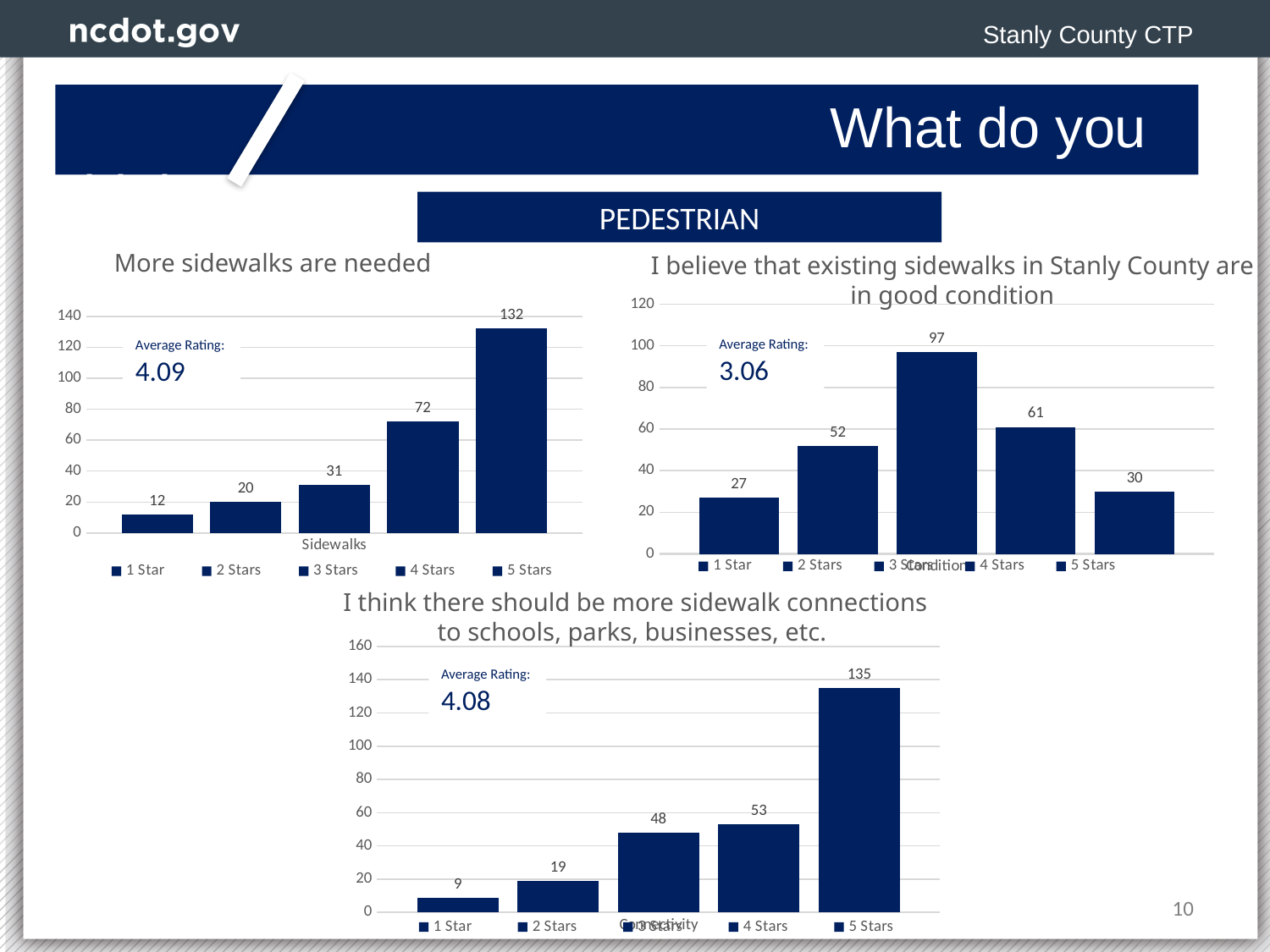
In the 'I believe that existing sidewalks in Stanly County are in good condition' chart, which is larger, the value for 1 Star or the value for 5 Stars? 5 Stars In the 'I believe that existing sidewalks in Stanly County are in good condition' chart, what is the value for 2 Stars? 52 In the 'I think there should be more sidewalk connections to schools, parks, businesses, etc.' chart, what is the value for 1 Star? 9 In the 'I think there should be more sidewalk connections to schools, parks, businesses, etc.' chart, what is the difference between the 5 Stars and 4 Stars values? 82 In the 'More sidewalks are needed' chart, what is the value for 5 Stars? 132 What average rating is shown on the 'I think there should be more sidewalk connections to schools, parks, businesses, etc.' chart? 4.08 In the 'More sidewalks are needed' chart, what is the difference between the 4 Stars and 3 Stars values? 41 In the 'I think there should be more sidewalk connections to schools, parks, businesses, etc.' chart, is the value for 5 Stars greater or less than 120? greater In the 'I believe that existing sidewalks in Stanly County are in good condition' chart, which rating has the highest value? 3 Stars What kind of chart is the 'I believe that existing sidewalks in Stanly County are in good condition' chart? Bar chart In the 'More sidewalks are needed' chart, which rating has the lowest value? 1 Star How many series does the legend list in the 'More sidewalks are needed' chart? 5